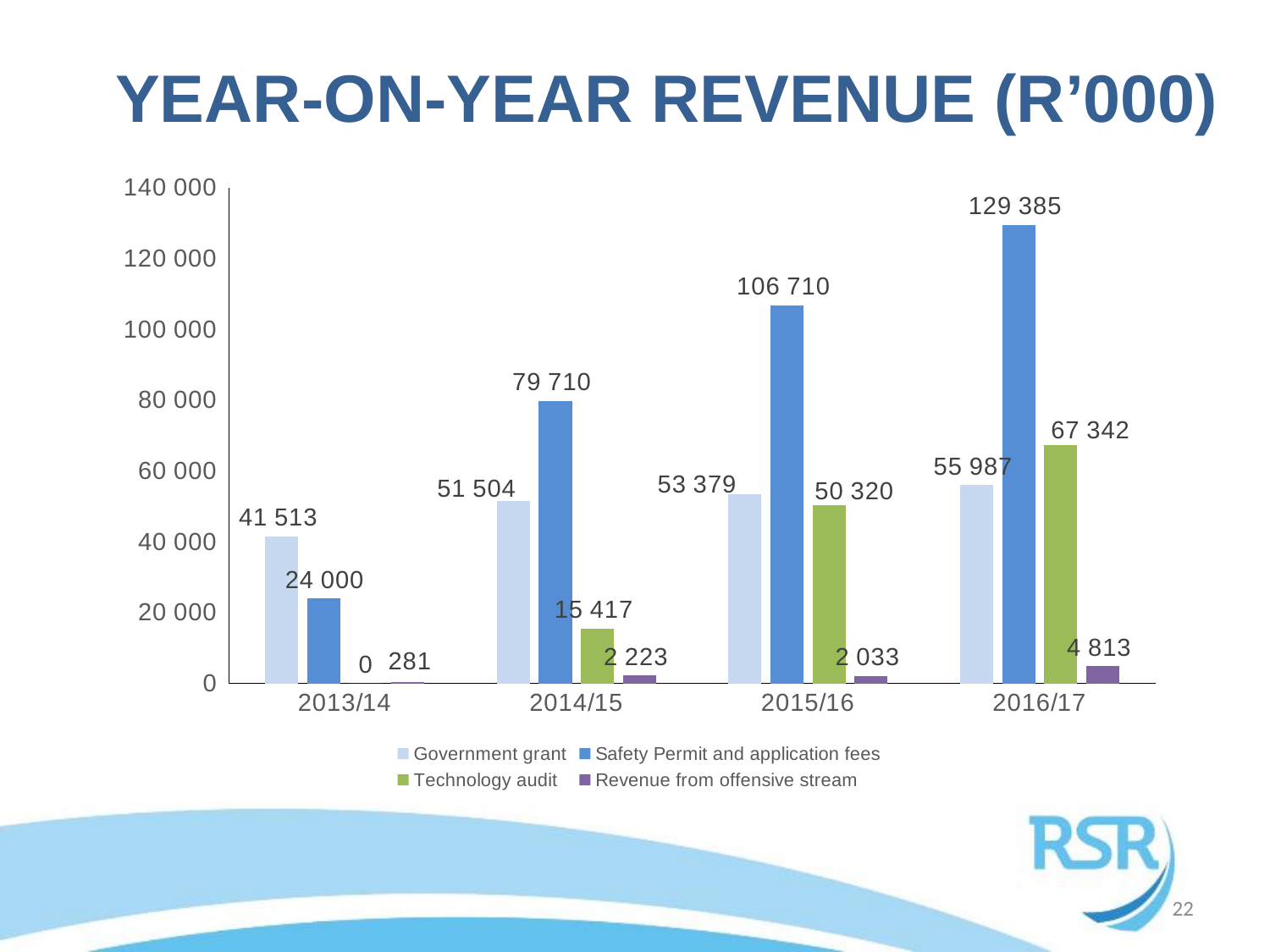
How many series does the legend list? 4 What is the difference between the Safety Permit and application fees revenue in 2016/17 and in 2015/16? 22 675 Which was larger in 2014/15: the Government grant or the Safety Permit and application fees? Safety Permit and application fees In which year was the Technology audit revenue lowest? 2013/14 What was the Safety Permit and application fees revenue in 2016/17? 129 385 In which year was the Safety Permit and application fees revenue highest? 2016/17 What kind of chart is shown on the slide? Bar chart What was the Revenue from offensive stream in 2014/15? 2 223 Does the Safety Permit and application fees revenue rise or fall from 2013/14 to 2016/17? Rise What was the Government grant in 2013/14? 41 513 What was the Technology audit revenue in 2015/16? 50 320 How many financial years are shown on the x axis? 4